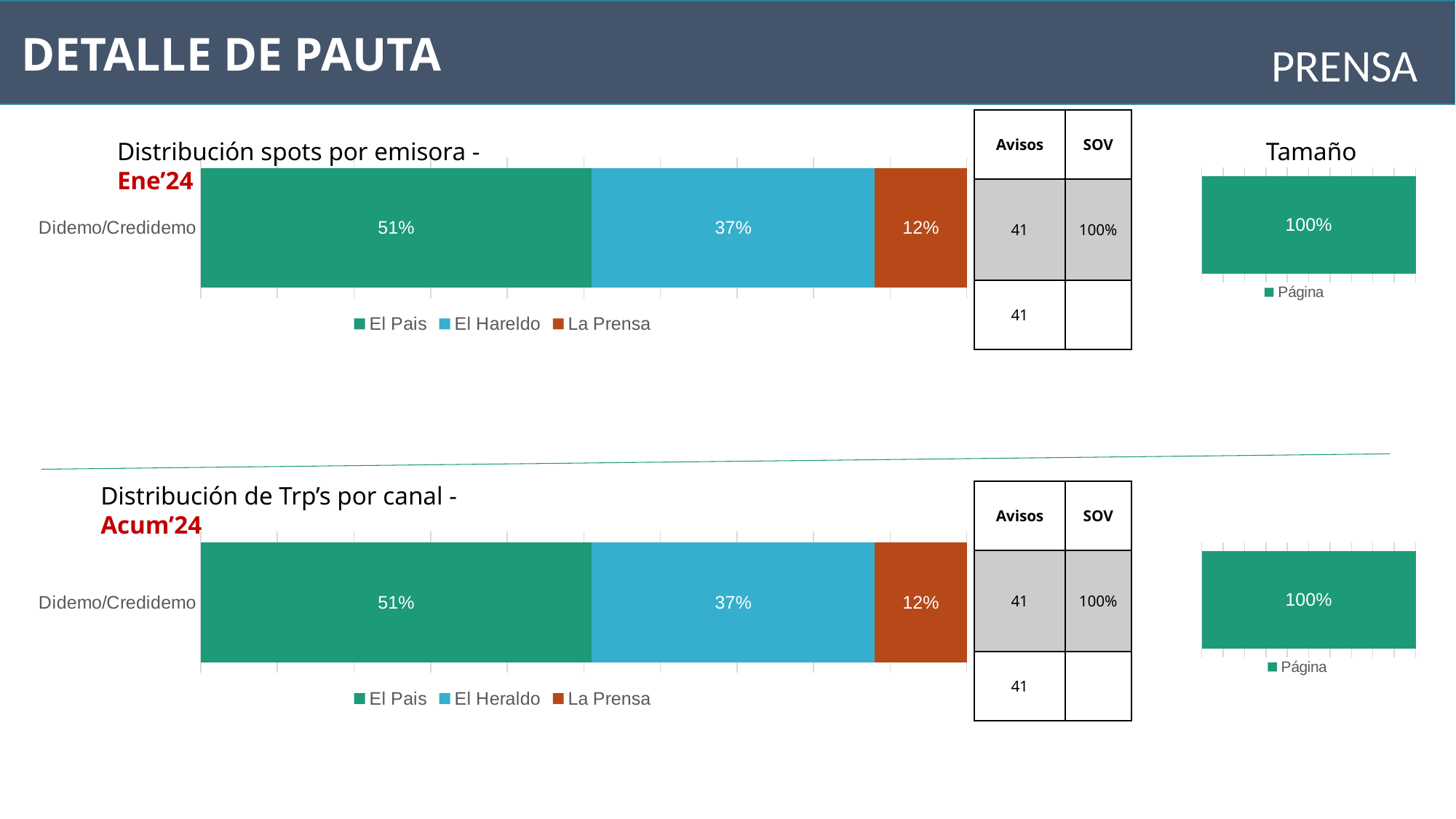
In the 'Tamaño' chart at the top right, what is the value for Página? 100% In the 'Distribución spots por emisora - Ene'24' chart, what is the difference between the El Pais and El Hareldo values? 14% In the 'Distribución de Trp's por canal - Acum'24' chart, which series has the smallest share of the bar? La Prensa In the 'Distribución spots por emisora - Ene'24' chart, which series has the largest share of the bar? El Pais In the 'Distribución spots por emisora - Ene'24' chart, what is the value for El Pais? 51% In the 'Distribución de Trp's por canal - Acum'24' chart, what is the value for El Heraldo? 37% In the 'Distribución de Trp's por canal - Acum'24' chart, what is the total of the stacked bar for Didemo/Credidemo? 100% In the 'Distribución spots por emisora - Ene'24' chart, what is the value for La Prensa? 12% What kind of chart is the 'Distribución de Trp's por canal - Acum'24' chart? Stacked bar chart What category label is shown on the y axis of the 'Distribución spots por emisora - Ene'24' chart? Didemo/Credidemo How many series does the legend of the 'Distribución spots por emisora - Ene'24' chart list? 3 In the 'Distribución de Trp's por canal - Acum'24' chart, which is larger, El Heraldo or La Prensa? El Heraldo